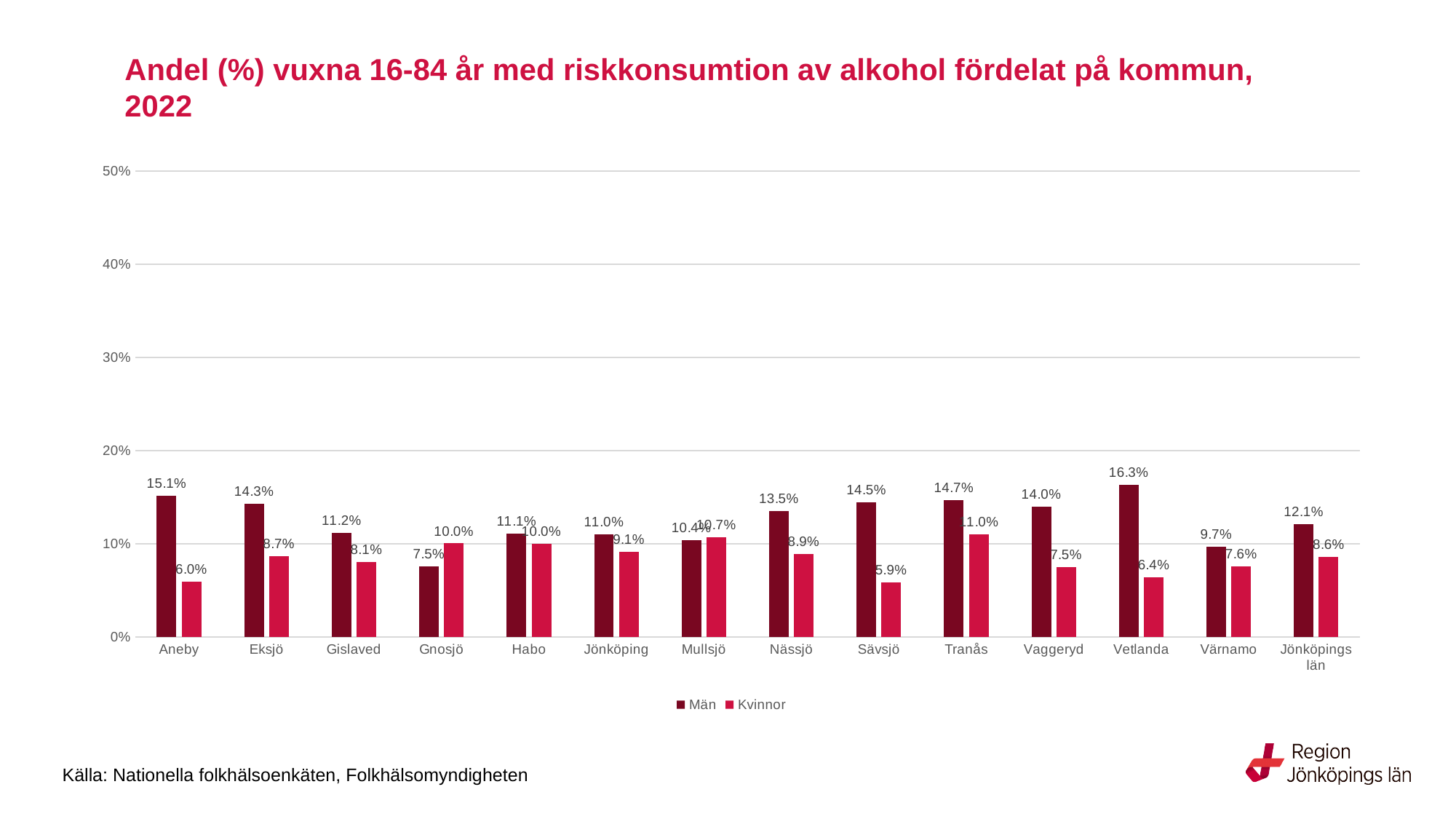
How many categories are shown on the x axis? 14 What is the value for Kvinnor in Aneby? 6.0% Which municipality has the lowest value for Kvinnor? Sävsjö What is the value for Kvinnor in Tranås? 11.0% Which is larger in Gnosjö, the value for Män or for Kvinnor? Kvinnor What is the value for Män in Vetlanda? 16.3% What is the difference between Män and Kvinnor in Sävsjö? 8.6% What kind of chart is shown on the slide? Bar chart Which municipality has the lowest value for Män? Gnosjö What is the value for Män in Jönköpings län? 12.1% Which municipality has the highest value for Män? Vetlanda How many series does the legend list? 2